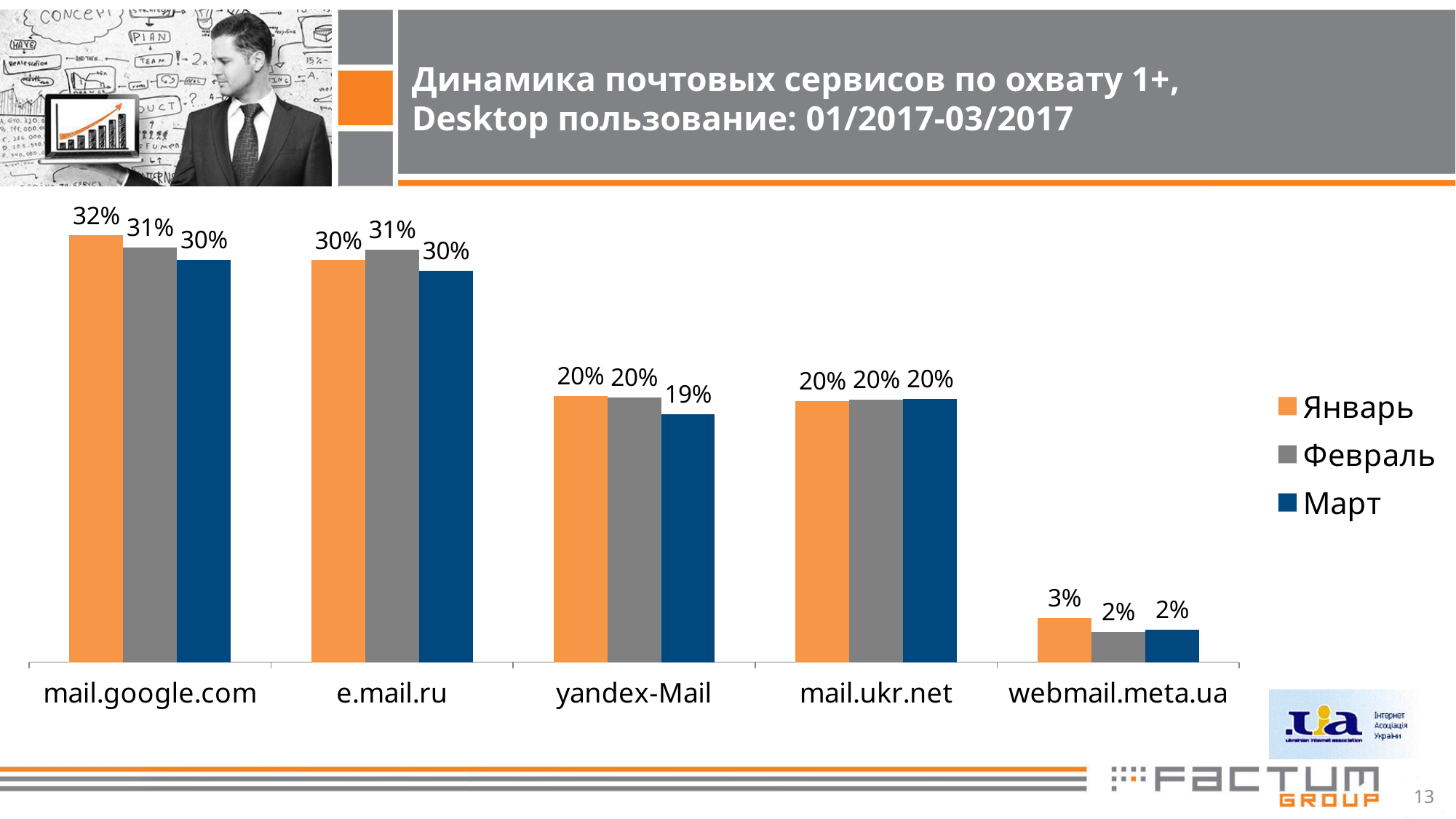
What kind of chart is shown on the slide? bar chart What is the value for mail.google.com in Январь? 32% Which category has the lowest value in Январь? webmail.meta.ua How many series does the legend list? 3 What is the value for e.mail.ru in Февраль? 31% Which colour represents Март in the legend? dark blue What is the difference between the Январь and Март values for mail.google.com? 2% How many categories are shown on the x axis? 5 What is the value for webmail.meta.ua in Февраль? 2% Which category has the highest value in Январь? mail.google.com Which is larger: the Март value for e.mail.ru or the Март value for mail.ukr.net? e.mail.ru What is the value for yandex-Mail in Март? 19%